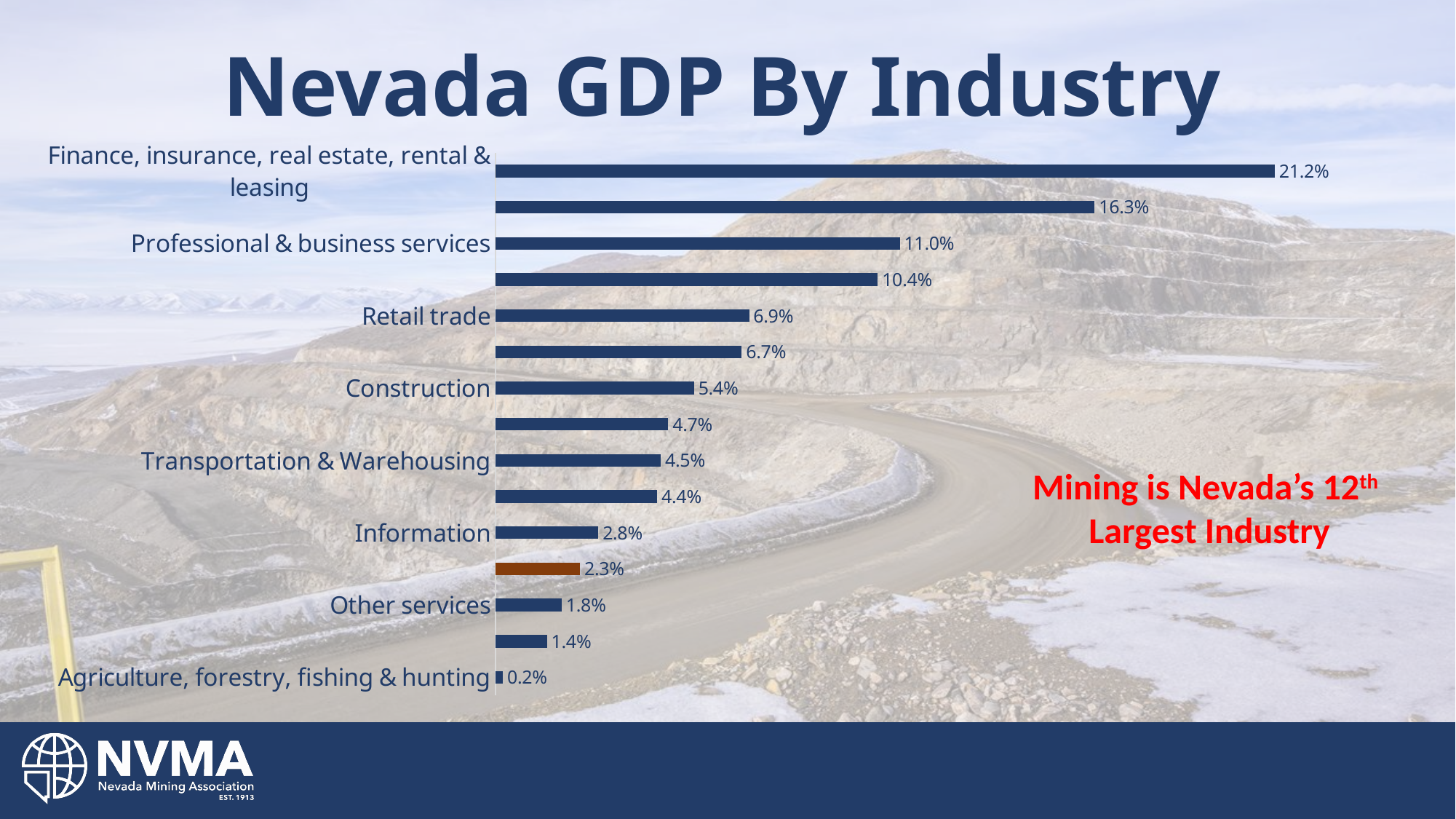
How many bars are plotted in the chart? 15 What is the value for Retail trade? 6.9% What is the value for Finance, insurance, real estate, rental & leasing? 21.2% Which industry has the highest share of Nevada GDP? Finance, insurance, real estate, rental & leasing What is the value for Professional & business services? 11.0% What is the value for Agriculture, forestry, fishing & hunting? 0.2% What is the value for Transportation & Warehousing? 4.5% Which is larger, the value for Retail trade or the value for Construction? Retail trade What is the value for Construction? 5.4% Which industry has the lowest share of Nevada GDP? Agriculture, forestry, fishing & hunting What value is labelled on the single orange bar in the chart? 2.3% What is the difference between the values for Finance, insurance, real estate, rental & leasing and Professional & business services? 10.2%